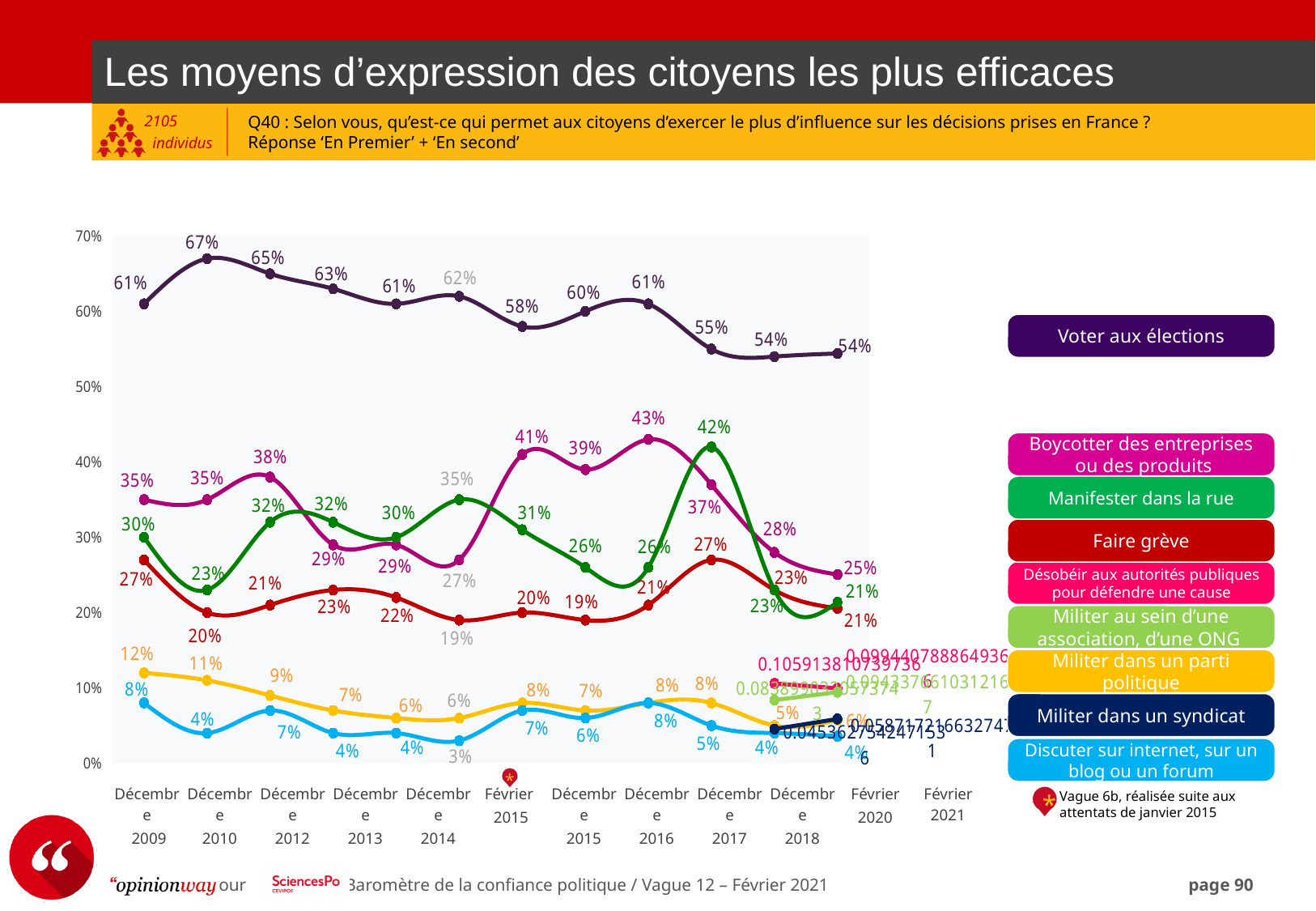
Does the 'Voter aux élections' line rise or fall overall from Décembre 2010 to Février 2021? fall What is the difference between the 'Voter aux élections' value in Décembre 2010 and in Février 2021? 13 percentage points What is the value for 'Voter aux élections' in Février 2015? 62% How many series does the legend list? 9 In which wave does 'Voter aux élections' reach its highest value? Décembre 2010 (67%) What is the value for 'Faire grève' in Décembre 2009? 27% In which wave does 'Discuter sur internet, sur un blog ou un forum' reach its lowest value? Février 2015 (3%) What is the value for 'Manifester dans la rue' in Décembre 2018? 42% What is the value for 'Boycotter des entreprises ou des produits' in Décembre 2017? 43% In Décembre 2017, which is higher: 'Boycotter des entreprises ou des produits' or 'Manifester dans la rue'? Boycotter des entreprises ou des produits What kind of chart is shown on the slide? line chart How many survey waves (points) are shown along the x axis? 12